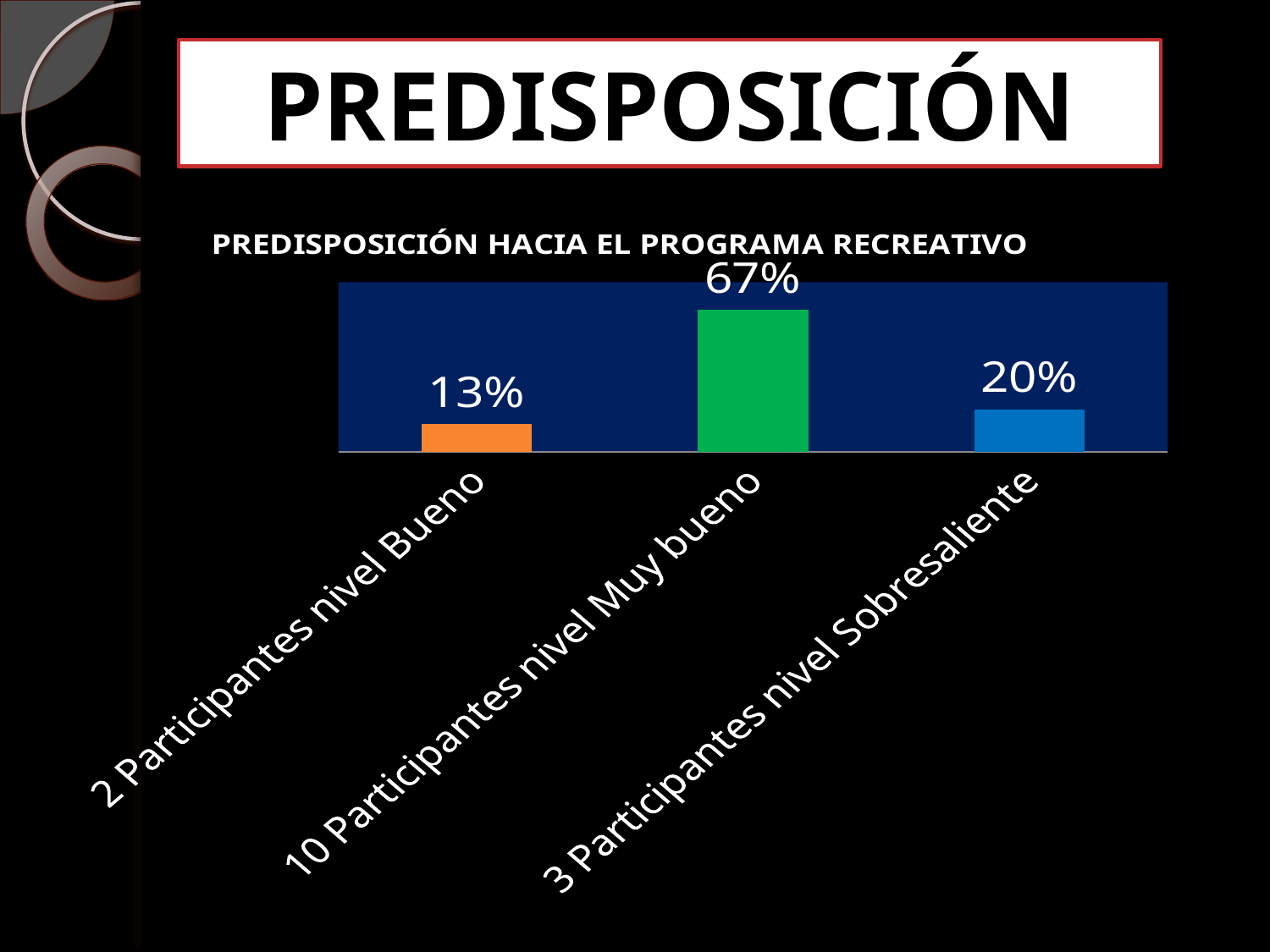
Which category has the highest value? 10 Participantes nivel Muy bueno Which category has the lowest value? 2 Participantes nivel Bueno What kind of chart is shown on the slide? Bar chart What is the title of the chart? PREDISPOSICIÓN HACIA EL PROGRAMA RECREATIVO What is the value for '10 Participantes nivel Muy bueno'? 67% What is the value for '3 Participantes nivel Sobresaliente'? 20% How many categories are shown in the chart? 3 What is the difference between the values for '3 Participantes nivel Sobresaliente' and '2 Participantes nivel Bueno'? 7% What colour is the bar for '10 Participantes nivel Muy bueno'? Green Which is larger, the value for '2 Participantes nivel Bueno' or '3 Participantes nivel Sobresaliente'? 3 Participantes nivel Sobresaliente What is the difference between the values for '10 Participantes nivel Muy bueno' and '3 Participantes nivel Sobresaliente'? 47% What is the value for '2 Participantes nivel Bueno'? 13%